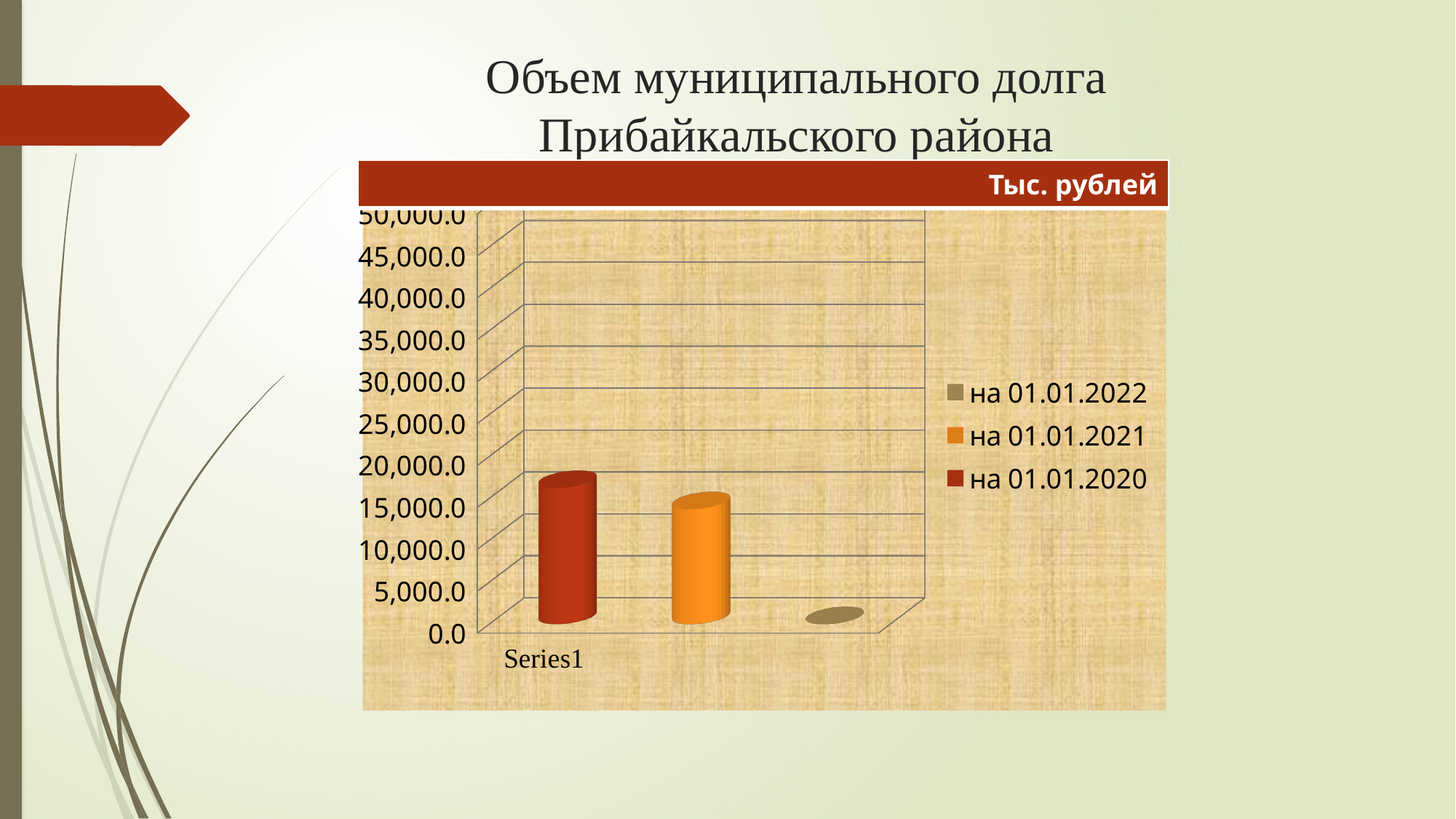
Is the value for на 01.01.2022 greater or less than 5,000.0? less Does the municipal debt rise or fall from 01.01.2020 to 01.01.2022? fall Is the value for на 01.01.2020 greater or less than 15,000.0? greater What kind of chart is shown on the slide? bar chart How many series does the legend list? 3 Which series has the highest value? на 01.01.2020 Is the value for на 01.01.2020 greater or less than 20,000.0? less Which is larger, the value for на 01.01.2020 or the value for на 01.01.2021? на 01.01.2020 Which series has the lowest value? на 01.01.2022 What unit is shown in the chart's header bar? Тыс. рублей What is the title of the slide? Объем муниципального долга Прибайкальского района